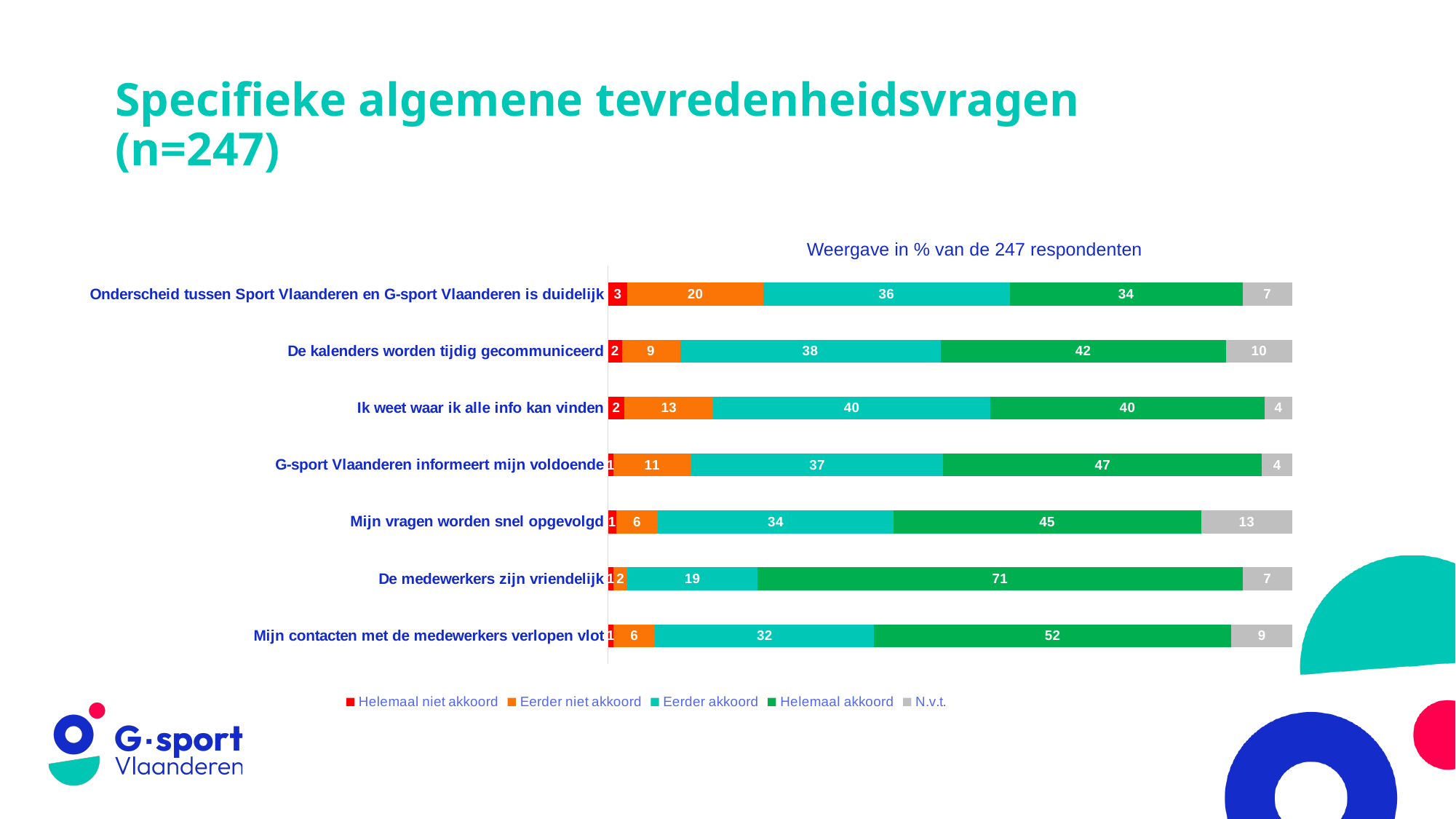
What is the difference between the 'Helemaal akkoord' values for 'Mijn contacten met de medewerkers verlopen vlot' and 'De kalenders worden tijdig gecommuniceerd'? 10 Which is larger: the 'Eerder akkoord' value for 'De kalenders worden tijdig gecommuniceerd' or for 'Mijn vragen worden snel opgevolgd'? De kalenders worden tijdig gecommuniceerd Which statement has the lowest 'Helemaal akkoord' value? Onderscheid tussen Sport Vlaanderen en G-sport Vlaanderen is duidelijk What kind of chart is shown on the slide? Stacked bar chart How many statements (categories) are shown in the chart? 7 What is the 'N.v.t.' value for 'Mijn vragen worden snel opgevolgd'? 13 What is the 'Eerder niet akkoord' value for 'Onderscheid tussen Sport Vlaanderen en G-sport Vlaanderen is duidelijk'? 20 Which statement has the highest 'Helemaal akkoord' value? De medewerkers zijn vriendelijk How many series does the legend list? 5 What is the 'Eerder akkoord' value for 'Ik weet waar ik alle info kan vinden'? 40 What is the total of the stacked bar for 'G-sport Vlaanderen informeert mijn voldoende'? 100 What is the 'Helemaal akkoord' value for 'De medewerkers zijn vriendelijk'? 71